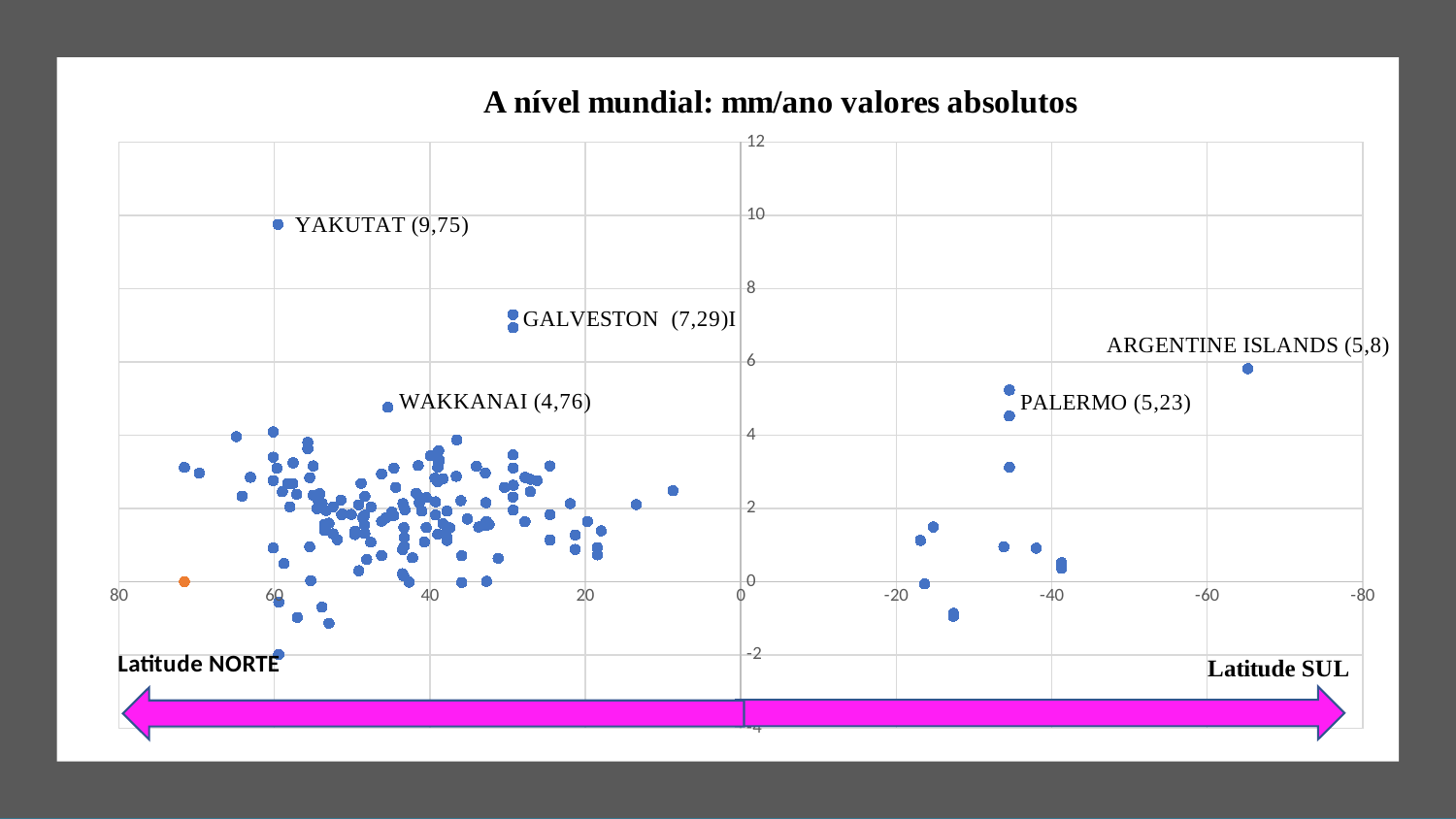
What value is labelled for GALVESTON? 7,29 Which has a larger labelled value, PALERMO or WAKKANAI? PALERMO Is the value for YAKUTAT greater or less than 8? greater What is the title of the chart? A nível mundial: mm/ano valores absolutos What value is labelled for YAKUTAT? 9,75 What value is labelled for ARGENTINE ISLANDS? 5,8 Which of the labelled locations has the highest value? YAKUTAT What is the difference between the labelled values for YAKUTAT and GALVESTON? 2,46 Which of the labelled locations has the lowest value? WAKKANAI What value is labelled for PALERMO? 5,23 What kind of chart is shown on the slide? scatter chart What label appears at the left end of the horizontal axis arrow? Latitude NORTE